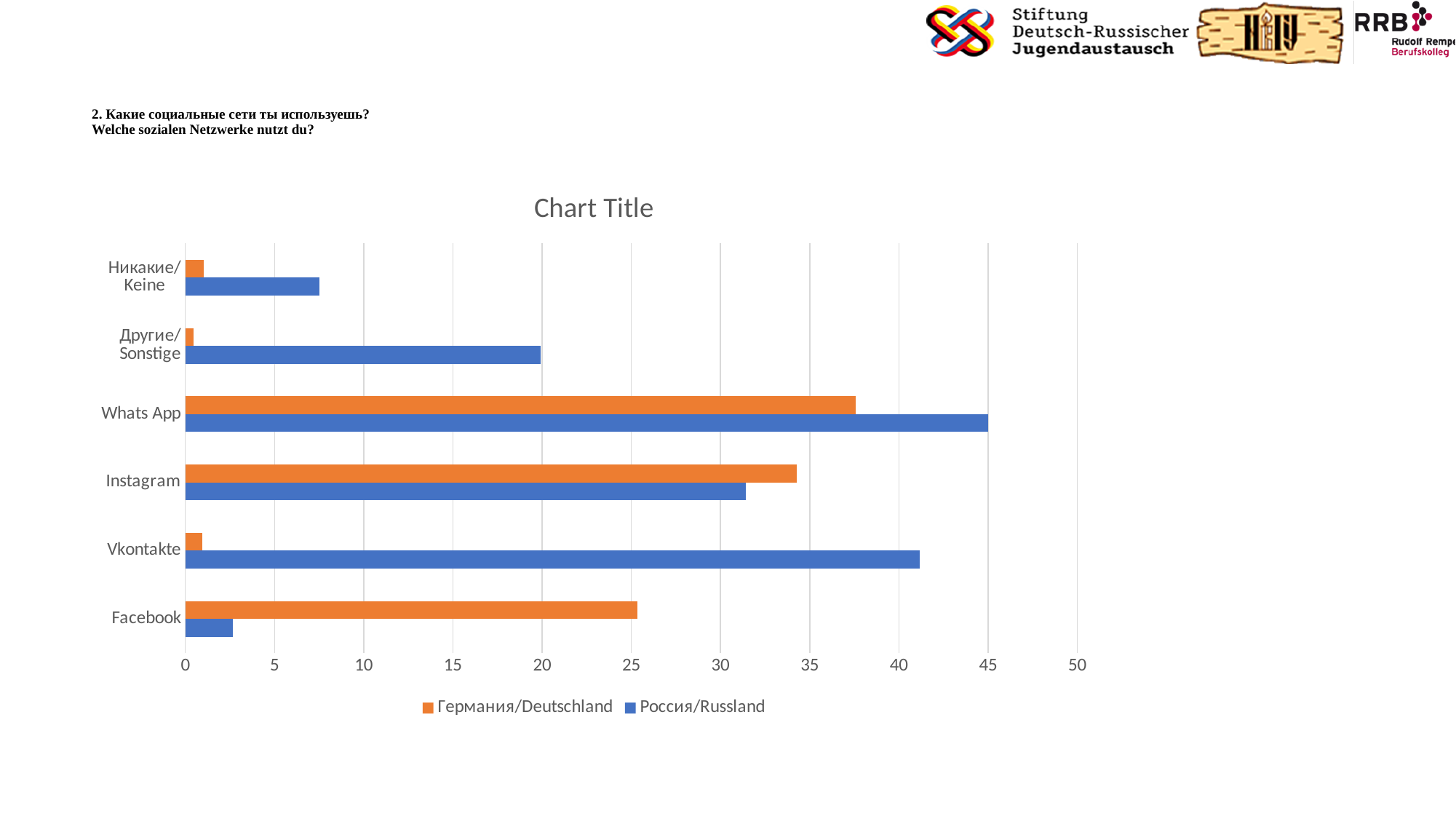
Which colour represents the Россия/Russland series? blue For Facebook, which series has the larger value, Германия/Deutschland or Россия/Russland? Германия/Deutschland What kind of chart is shown on the slide? bar chart Is the value for Vkontakte in the Россия/Russland series greater or less than 40? greater What is the title of the chart? Chart Title How many categories are shown on the chart? 6 For Vkontakte, which series has the larger value, Германия/Deutschland or Россия/Russland? Россия/Russland Which category has the lowest value for Россия/Russland? Facebook Which category has the highest value for Россия/Russland? Whats App Is the value for Другие/Sonstige in the Россия/Russland series greater or less than 25? less Which category has the highest value for Германия/Deutschland? Whats App How many series does the legend list? 2